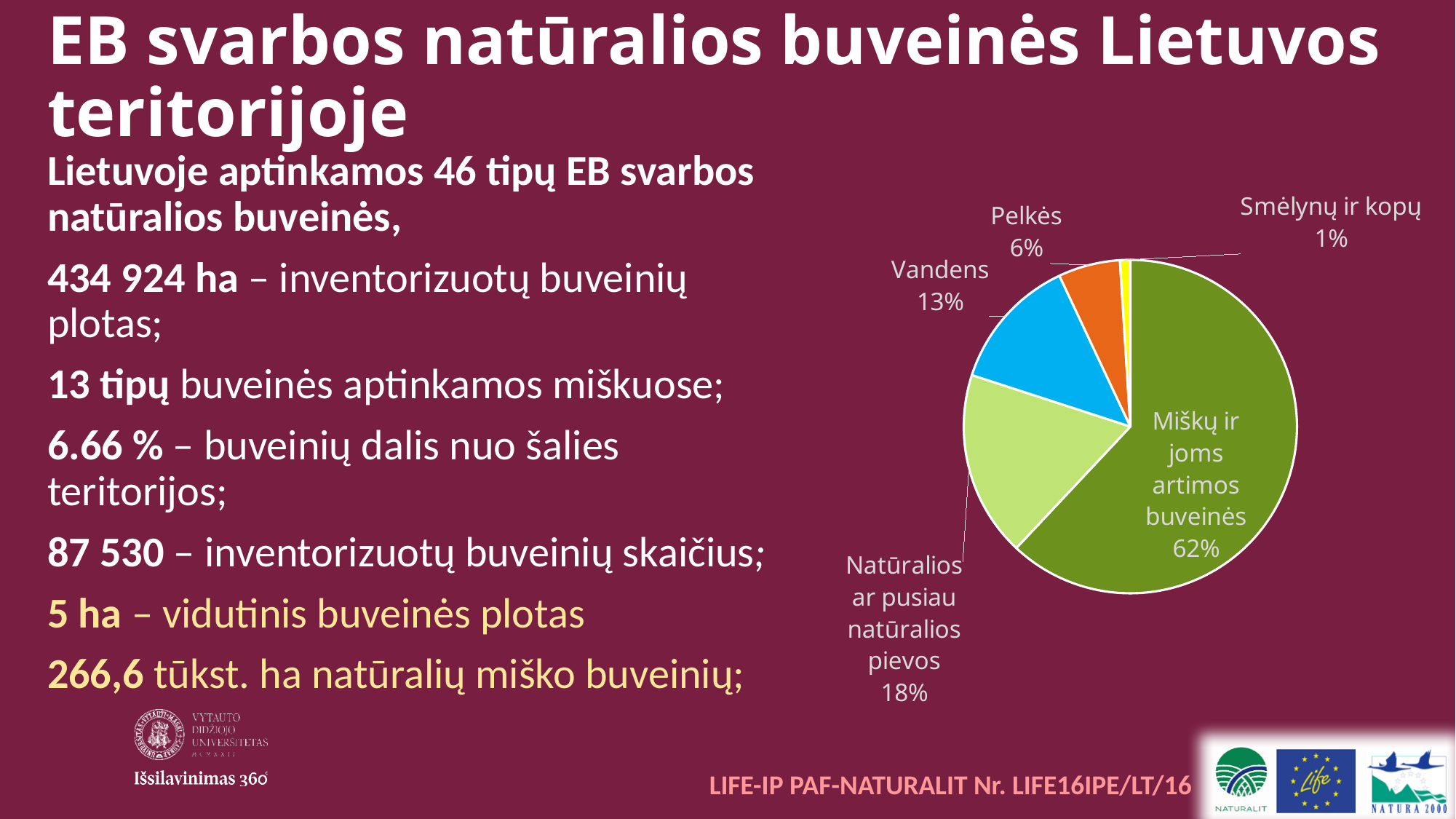
How many slices does the pie chart have? 5 What colour is the slice for "Vandens"? blue Which category has the smallest slice of the pie? Smėlynų ir kopų What is the difference in percentage points between "Natūralios ar pusiau natūralios pievos" and "Vandens"? 5 What is the value shown for "Vandens"? 13% What share of the pie does "Natūralios ar pusiau natūralios pievos" take? 18% What is the value shown for "Smėlynų ir kopų"? 1% What share of the pie does "Miškų ir joms artimos buveinės" take? 62% Which category has the largest slice of the pie? Miškų ir joms artimos buveinės What kind of chart is shown on the slide? pie chart What is the value shown for "Pelkės"? 6% Which is larger, the share for "Pelkės" or the share for "Vandens"? Vandens